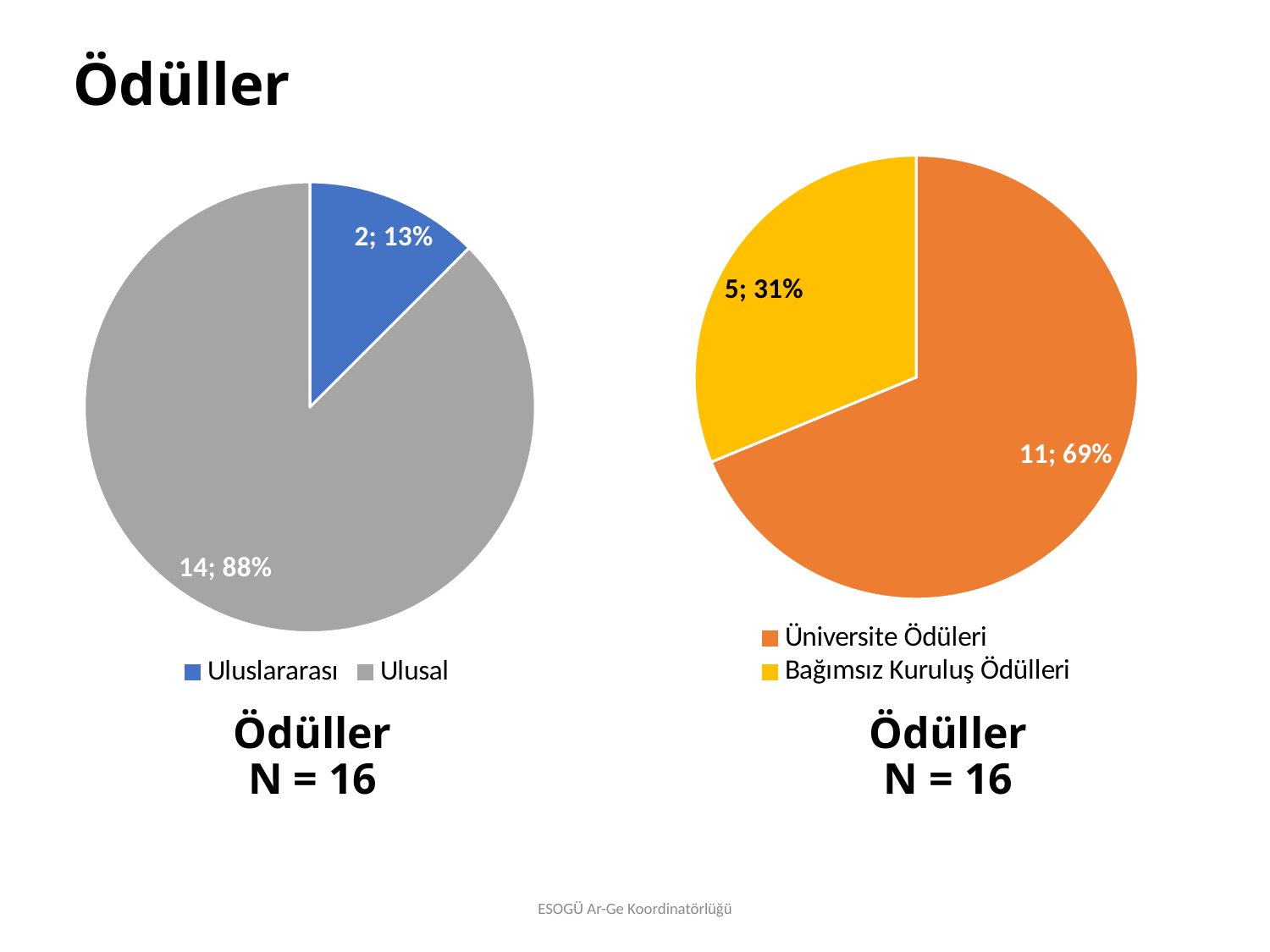
In the right pie chart, what is the difference between the values for Üniversite Ödüleri and Bağımsız Kuruluş Ödülleri? 6 What kind of chart is the left chart on the slide? Pie chart In the left pie chart, what is the difference between the values for Ulusal and Uluslararası? 12 In the right pie chart, what share of the pie does Bağımsız Kuruluş Ödülleri represent? 31% In the right pie chart, what is the value for Bağımsız Kuruluş Ödülleri? 5 In the left pie chart, what share of the pie does Ulusal represent? 88% In the right pie chart, which category is the smallest? Bağımsız Kuruluş Ödülleri In the right pie chart, what is the value for Üniversite Ödüleri? 11 In the left pie chart, what share of the pie does Uluslararası represent? 13% In the left pie chart, what is the value for Ulusal? 14 In the left pie chart, which category is the largest? Ulusal In the left pie chart, what is the value for Uluslararası? 2